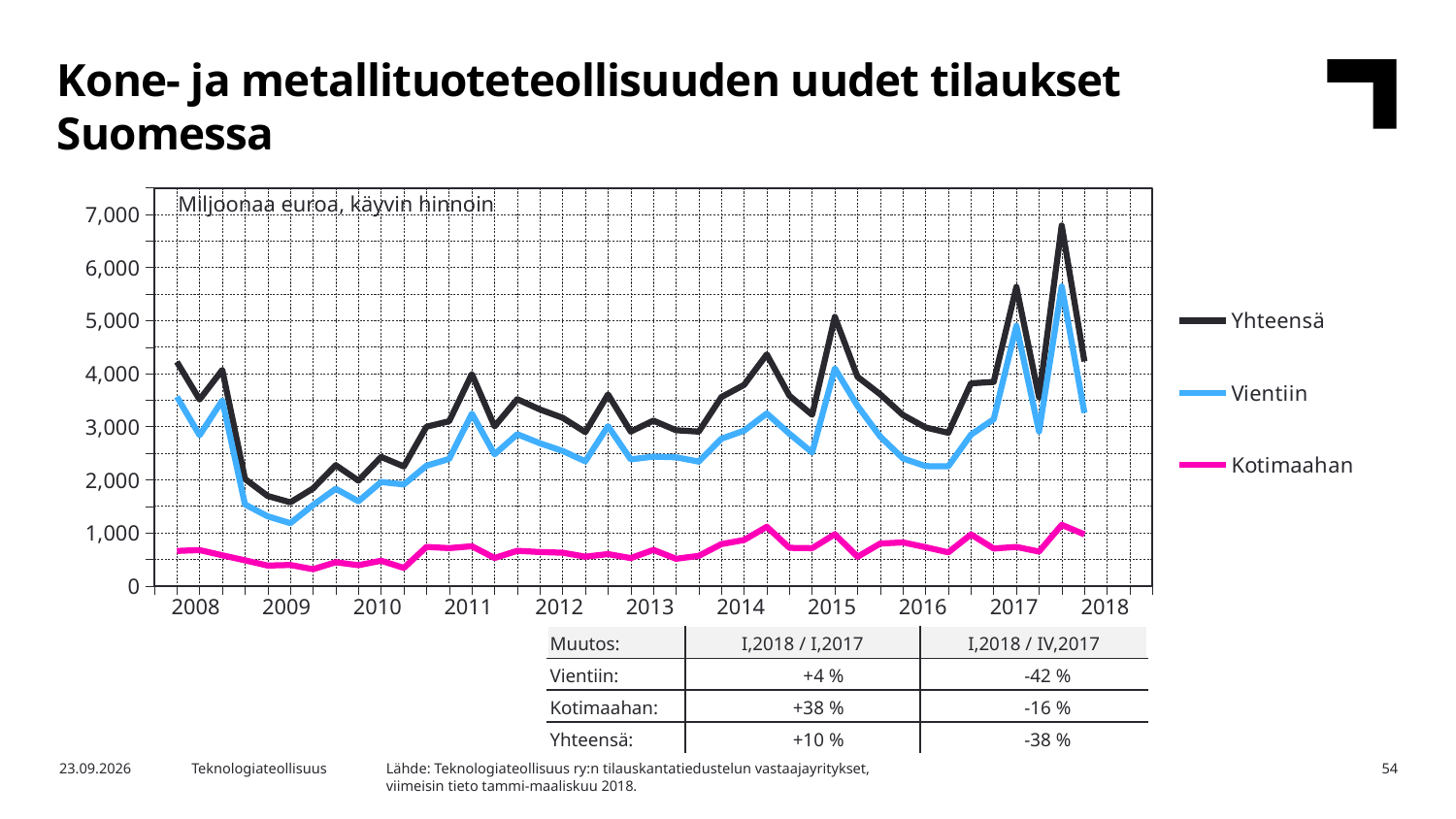
Which series are listed in the chart legend? Yhteensä, Vientiin, Kotimaahan Which is larger at every point on the chart, Vientiin or Kotimaahan? Vientiin What kind of chart is shown on the slide? line chart Is the highest value of the Kotimaahan line greater or less than 2,000? less Does the Yhteensä line rise or fall from the start of 2008 to 2009? fall What unit is stated at the top of the chart area? Miljoonaa euroa, käyvin hinnoin How many year labels are shown on the x axis? 11 Which series reaches the highest value on the chart? Yhteensä How many series does the legend list? 3 Is the peak value of the Vientiin line in 2017 greater or less than 5,000? greater Is the peak value of the Yhteensä line in 2017 greater or less than 6,000? greater Which series has the lowest values throughout the whole period? Kotimaahan